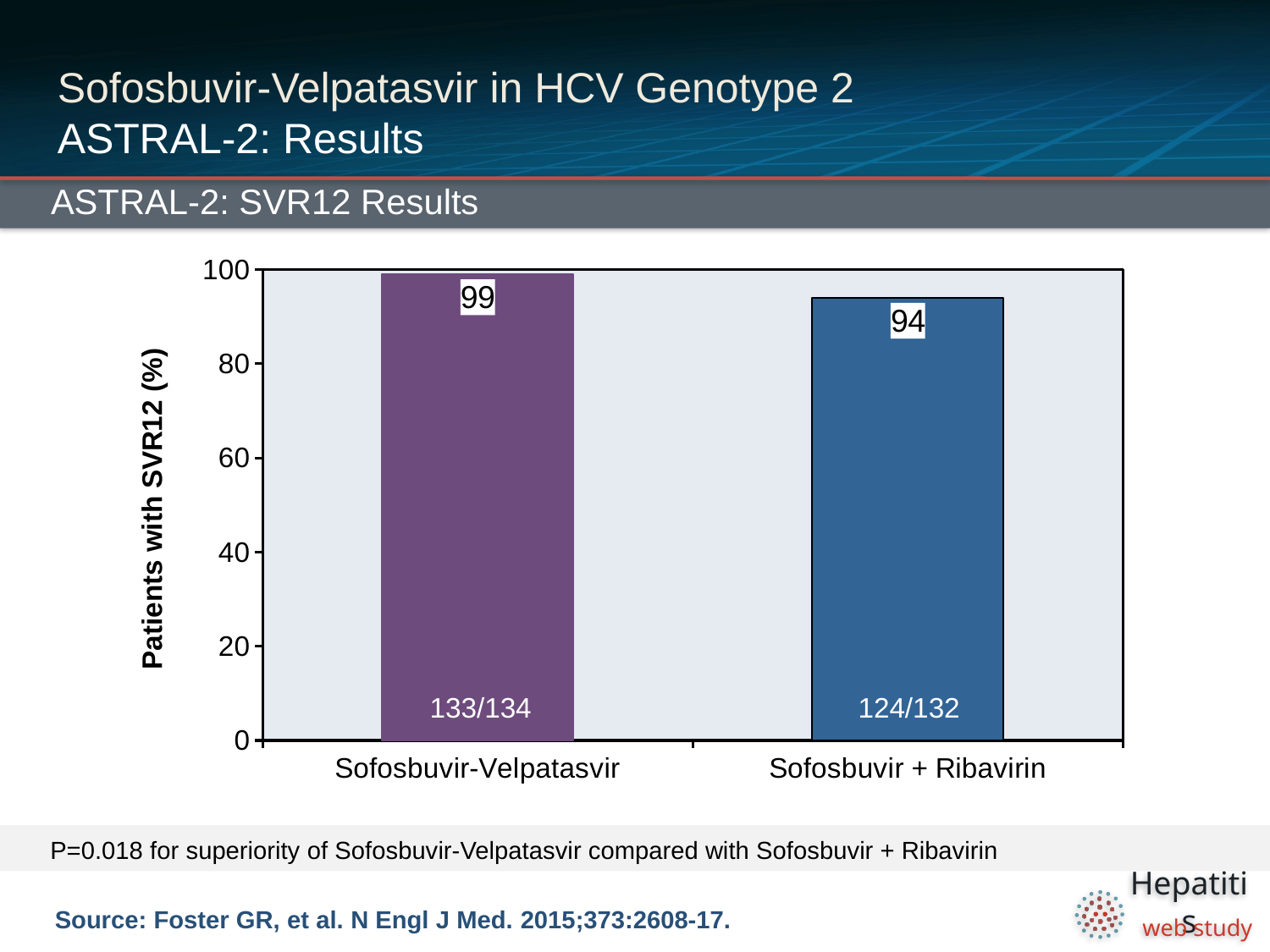
What fraction of patients is shown inside the Sofosbuvir + Ribavirin bar? 124/132 How many treatment arms are shown in the chart? 2 Which treatment arm has the lower SVR12 rate? Sofosbuvir + Ribavirin What is the title of the chart? ASTRAL-2: SVR12 Results What is the SVR12 rate for Sofosbuvir-Velpatasvir? 99 Is the SVR12 rate for Sofosbuvir + Ribavirin greater or less than 80? greater What is the SVR12 rate for Sofosbuvir + Ribavirin? 94 Which treatment arm has the higher SVR12 rate? Sofosbuvir-Velpatasvir What is the label of the y axis? Patients with SVR12 (%) What is the difference in SVR12 rate between Sofosbuvir-Velpatasvir and Sofosbuvir + Ribavirin? 5 What fraction of patients is shown inside the Sofosbuvir-Velpatasvir bar? 133/134 What kind of chart is shown on the slide? Bar chart